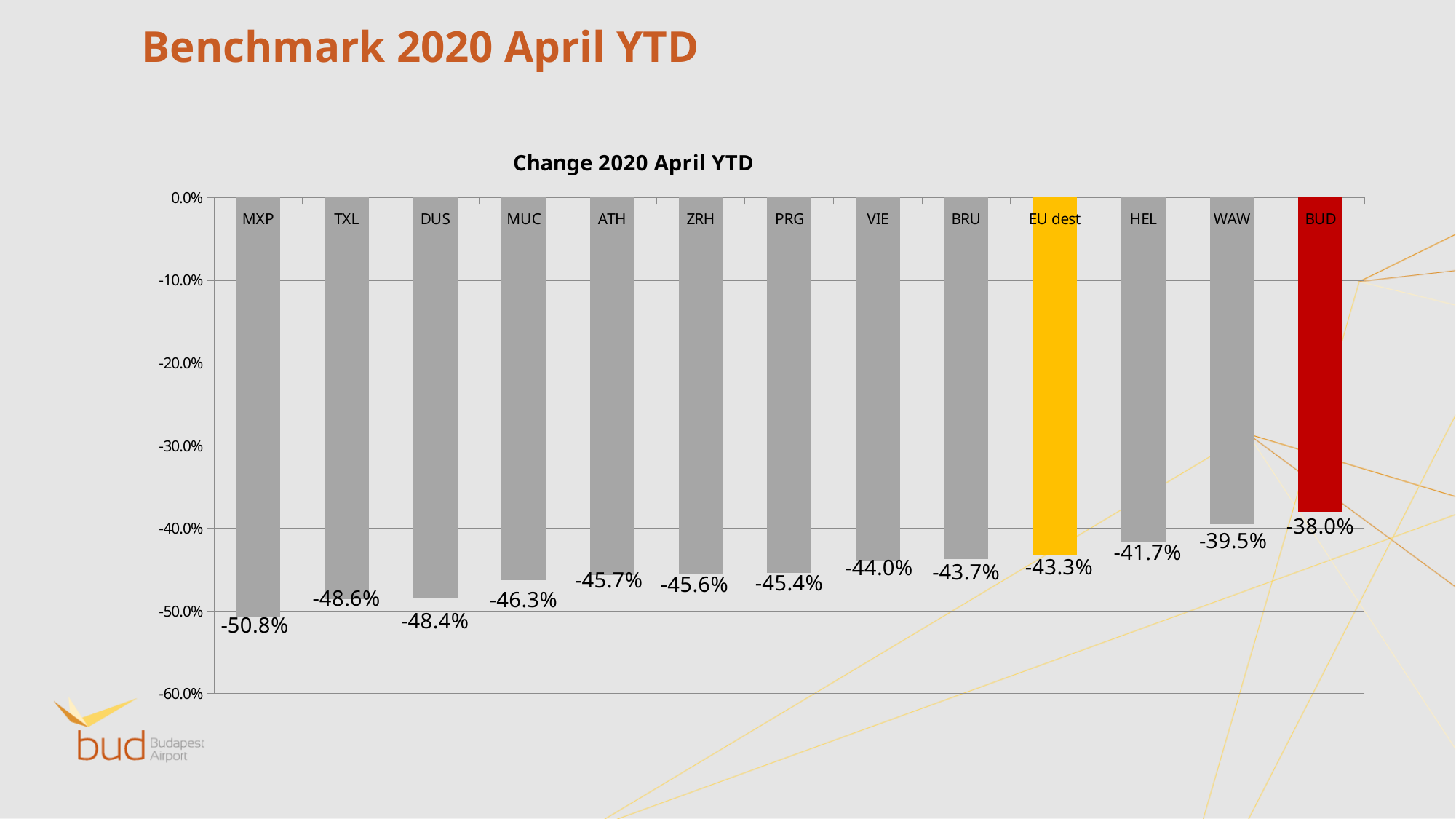
What is the title of the chart? Change 2020 April YTD Which category has the highest value (smallest decline)? BUD What is the difference between the values for BUD and EU dest? 5.3 percentage points What kind of chart is shown? Bar chart What is the value for HEL? -41.7% Which category has the lowest value (largest decline)? MXP What is the difference between the values for MXP and TXL? 2.2 percentage points How many categories are shown in the chart? 13 Which is larger, the value for WAW or the value for DUS? WAW What is the value for EU dest? -43.3% What is the value for MXP? -50.8% What is the value for BUD? -38.0%